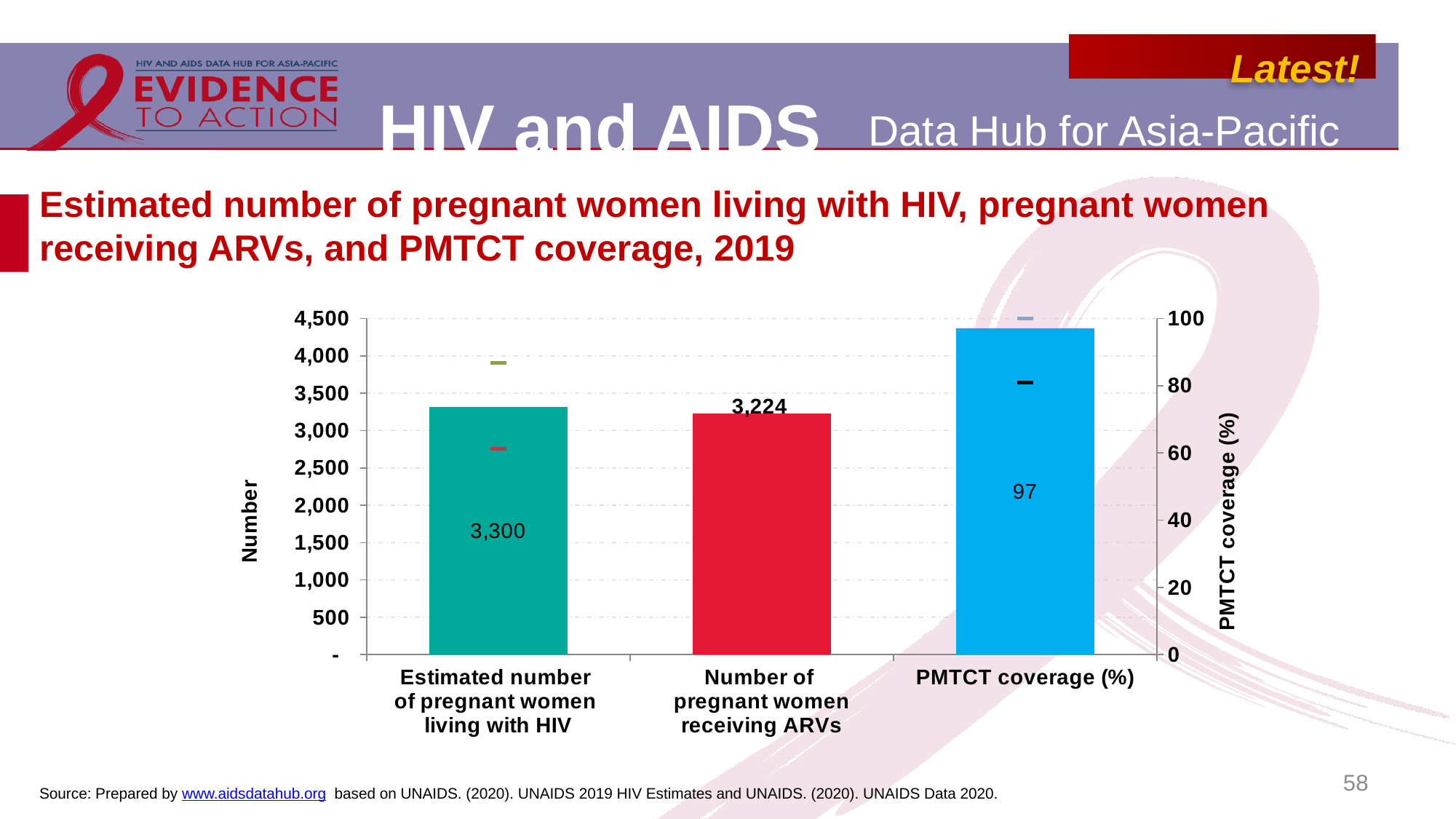
What kind of chart is shown on the slide? Bar chart How many bars are plotted on the chart? 3 What is the estimated number of pregnant women living with HIV shown on the chart? 3,300 What is the number of pregnant women receiving ARVs shown on the chart? 3,224 What year does the chart's data refer to, according to the slide title? 2019 Is the number of pregnant women receiving ARVs greater or less than 3,500? less What is the title of the right vertical axis of the chart? PMTCT coverage (%) What is the title of the left vertical axis of the chart? Number Is the PMTCT coverage (%) value greater or less than 80 on the right-hand axis? greater What is the difference between the estimated number of pregnant women living with HIV and the number of pregnant women receiving ARVs? 76 What is the PMTCT coverage (%) value shown on the chart? 97 Which is larger: the estimated number of pregnant women living with HIV or the number of pregnant women receiving ARVs? Estimated number of pregnant women living with HIV